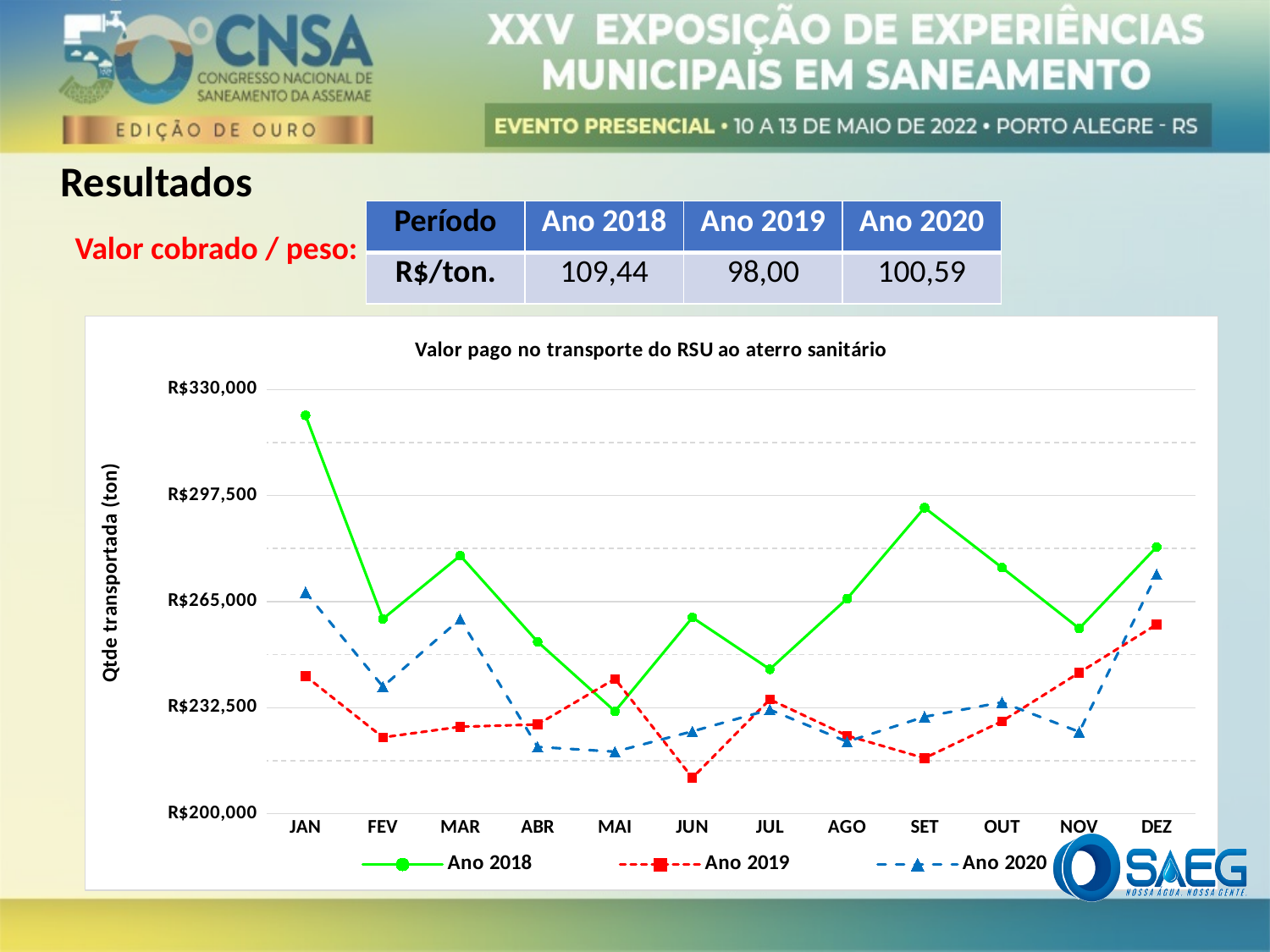
Is the value for Ano 2018 in JAN greater or less than R$297,500? greater Which series is drawn with a solid green line in the chart? Ano 2018 What is the title of the chart? Valor pago no transporte do RSU ao aterro sanitário How many months are plotted along the x axis of the chart? 12 In which month does the Ano 2018 series reach its lowest value? MAI In SET, which series has the larger value, Ano 2018 or Ano 2020? Ano 2018 What kind of chart is shown on the slide? line chart In which month does the Ano 2019 series reach its lowest value? JUN Does the Ano 2018 series rise or fall from JAN to FEV? fall How many series does the chart legend list? 3 Is the value for Ano 2019 in JUN greater or less than R$232,500? less In which month does the Ano 2018 series reach its highest value? JAN